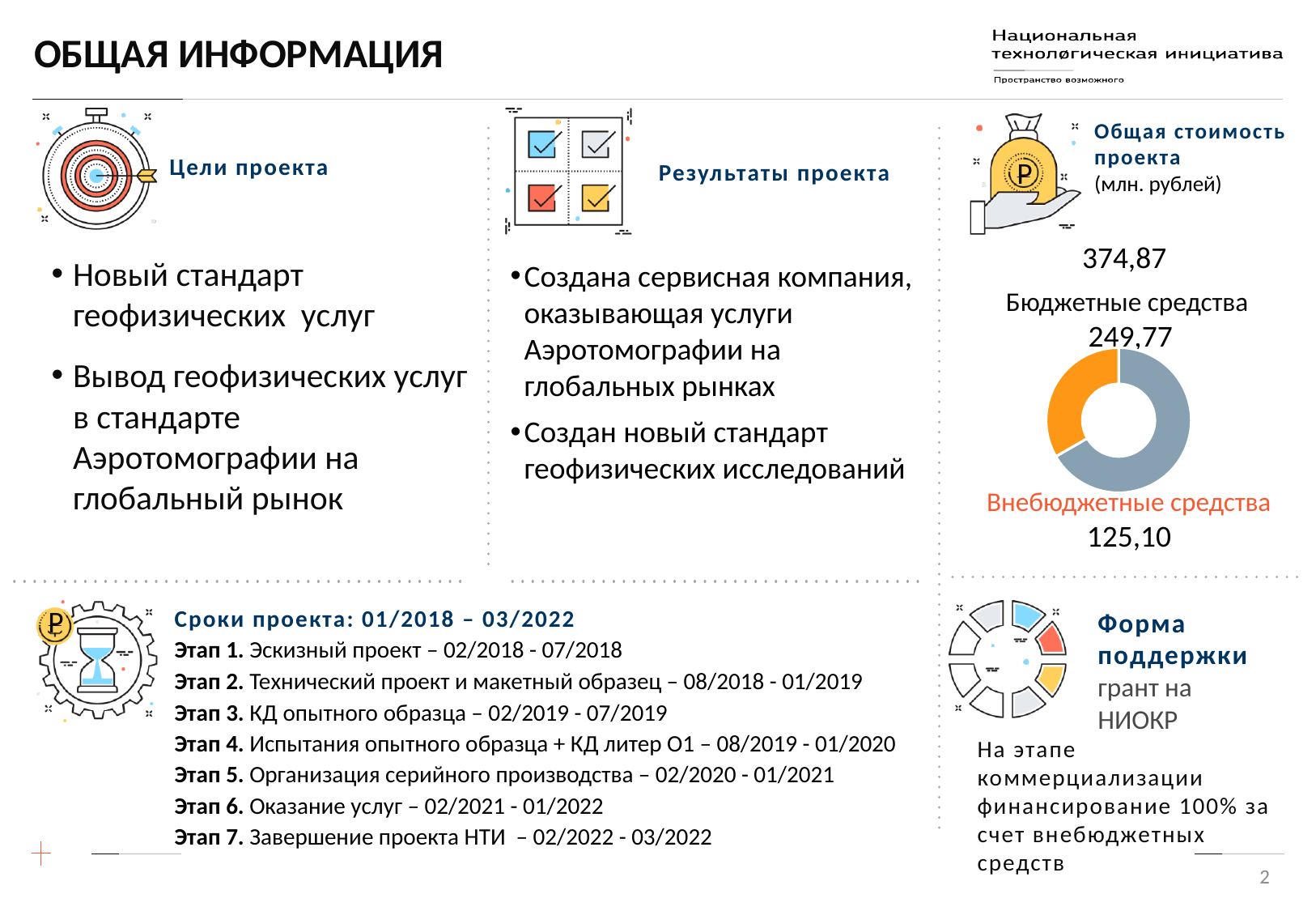
What type of chart is shown under "Общая стоимость проекта"? Donut (pie) chart How many segments does the donut chart have? 2 In what units is the total project cost given on the slide? млн. рублей What is the difference between Бюджетные средства and Внебюджетные средства in the donut chart? 124,67 What colour is the Внебюджетные средства segment in the donut chart? Orange What is the value for Бюджетные средства in the donut chart? 249,77 What is the total project cost (Общая стоимость проекта) shown above the donut chart? 374,87 Which segment of the donut chart is the largest? Бюджетные средства Which is larger in the donut chart: Бюджетные средства or Внебюджетные средства? Бюджетные средства Which segment of the donut chart is the smallest? Внебюджетные средства What is the value for Внебюджетные средства in the donut chart? 125,10